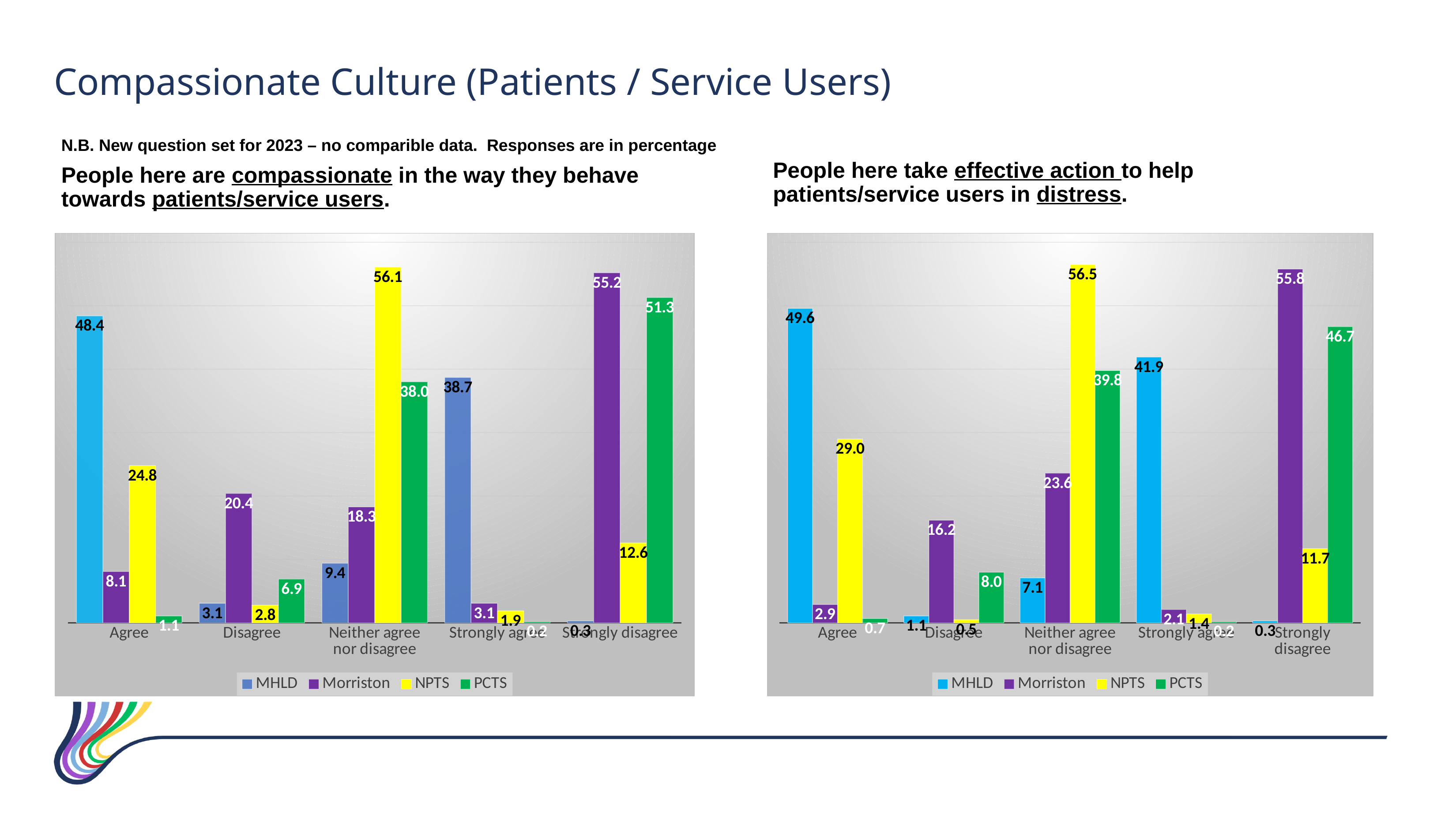
In the left chart (compassionate behaviour), what is the NPTS value for Neither agree nor disagree? 56.1 What type of chart is the left chart (compassionate behaviour)? Bar chart In the right chart (effective action), which series has the lowest value for Agree? PCTS In the left chart (compassionate behaviour), what is the difference between the MHLD values for Agree and Strongly agree? 9.7 In the left chart (compassionate behaviour), what is the MHLD value for Agree? 48.4 How many series does the legend of the left chart (compassionate behaviour) list? 4 In the left chart (compassionate behaviour), which series has the highest value for Strongly disagree? Morriston In the right chart (effective action), what is the PCTS value for Neither agree nor disagree? 39.8 In the right chart (effective action), what is the Morriston value for Strongly disagree? 55.8 How many response categories are shown on the x axis of the right chart (effective action)? 5 In the right chart (effective action), which is larger for Disagree: Morriston or PCTS? Morriston In the right chart (effective action), what is the difference between the NPTS and PCTS values for Neither agree nor disagree? 16.7